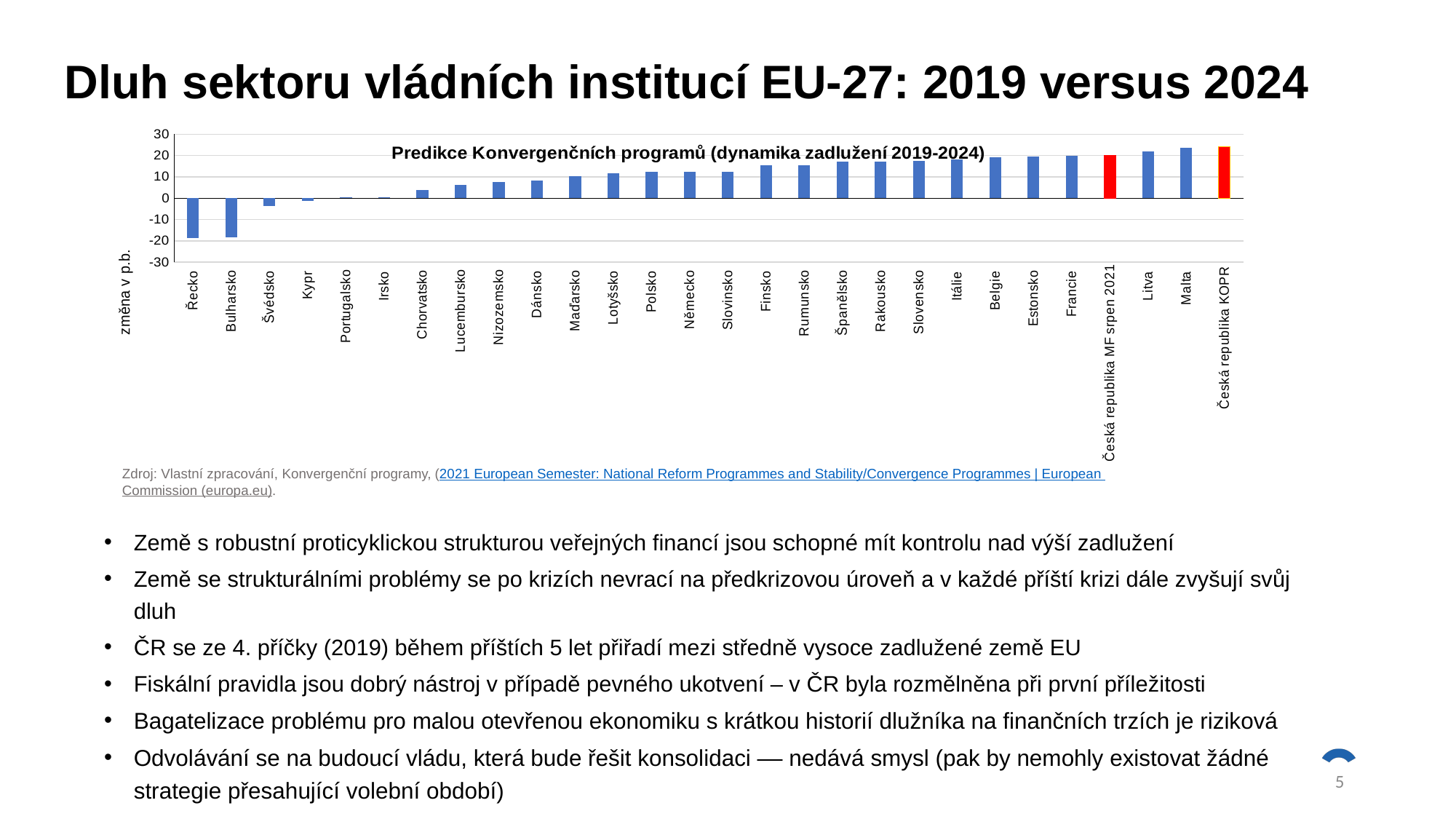
What is the label of the vertical axis? změna v p.b. Do the values generally rise or fall moving from left to right along the x axis? rise How many categories (bars) are plotted in the chart? 28 What kind of chart is shown on the slide? bar chart Is the value for Itálie greater or less than 10? greater Which has the larger value, Řecko or Malta? Malta Is the value for Chorvatsko greater or less than 10? less Which has the larger value, Francie or Polsko? Francie Is the value for Řecko greater or less than -10? less What is the title of the chart? Predikce Konvergenčních programů (dynamika zadlužení 2019-2024)